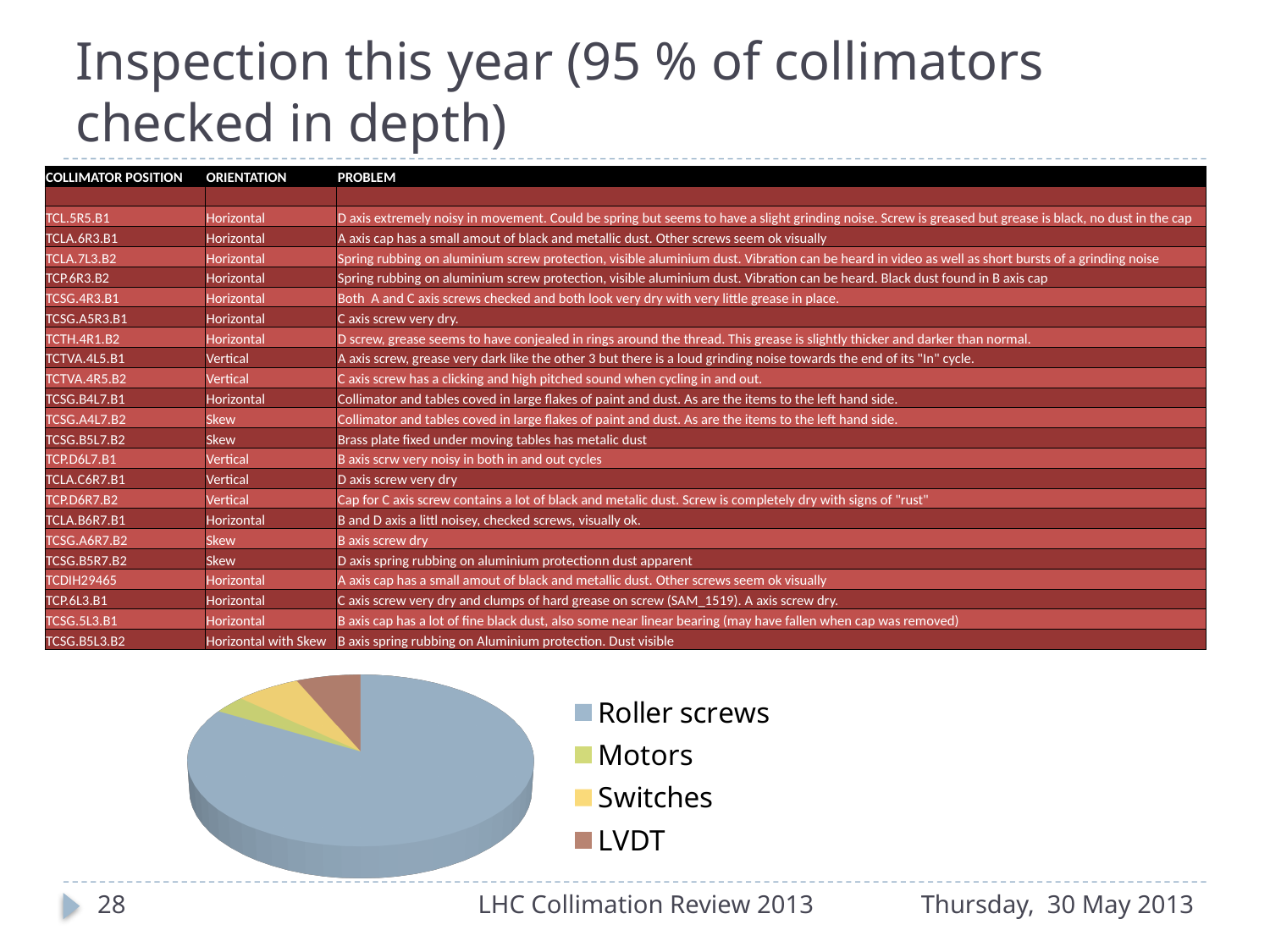
Which category has the largest slice of the pie chart? Roller screws What kind of chart is shown on the slide? pie chart Which slice is larger in the pie chart, Roller screws or Switches? Roller screws Which category has the smallest slice of the pie chart? Motors How many entries does the pie chart's legend list? 4 How many slices does the pie chart have? 4 Which legend entry is listed last in the pie chart's legend? LVDT Which slice is larger in the pie chart, Switches or Motors? Switches Which slice is larger in the pie chart, Roller screws or LVDT? Roller screws What colour is the Roller screws slice in the pie chart? blue